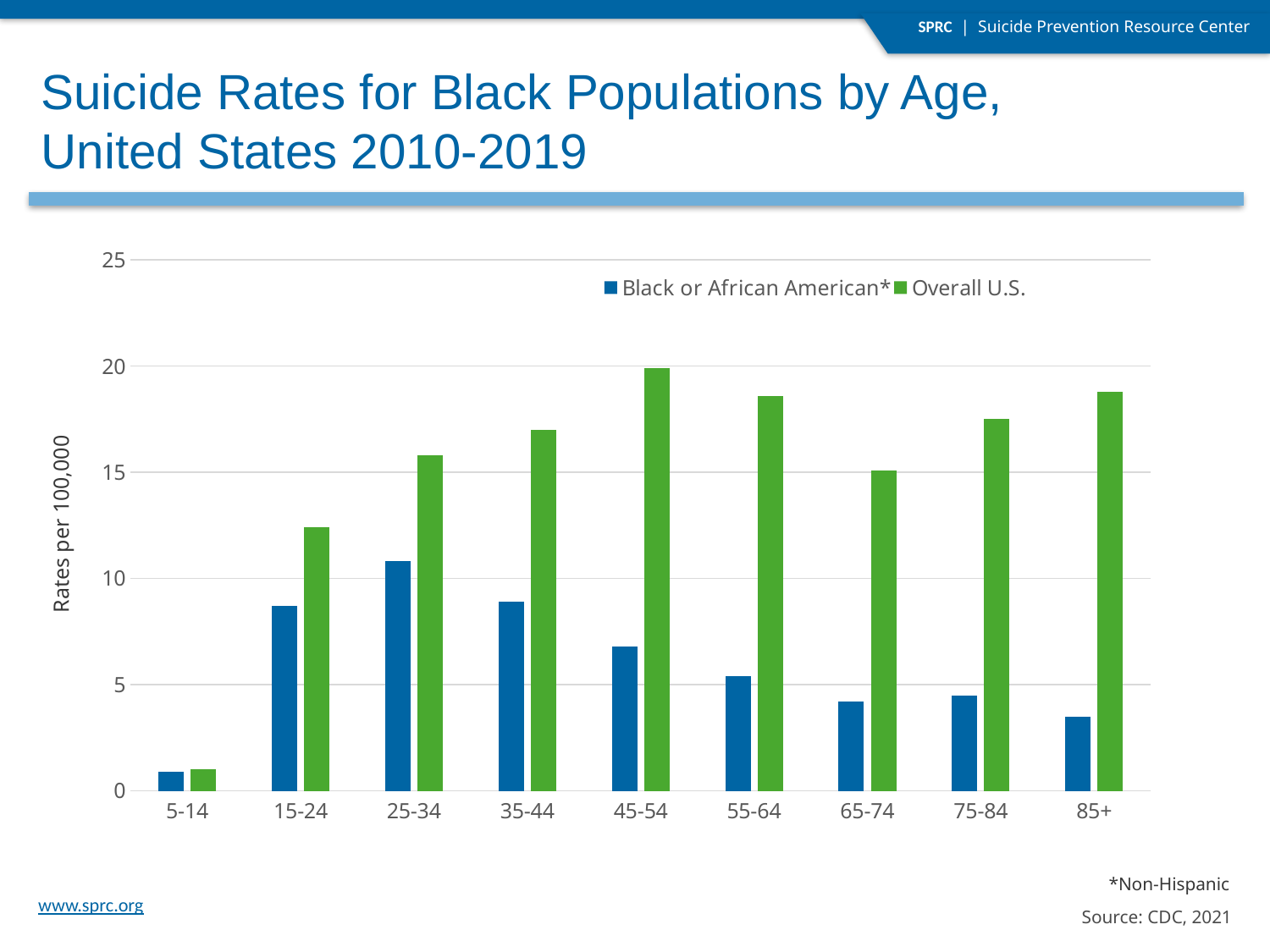
Is the Black or African American* rate for 65-74 greater or less than 5? less What is the label on the y axis? Rates per 100,000 Which age group has the highest rate for Overall U.S.? 45-54 For the 45-54 age group, which series has the larger value, Black or African American* or Overall U.S.? Overall U.S. Which age group has the highest rate for Black or African American*? 25-34 Which age group has the lowest rate for Overall U.S.? 5-14 Is the Black or African American* rate for 25-34 greater or less than 10? greater Does the Overall U.S. rate rise or fall from 5-14 to 45-54? Rise How many series does the legend list? 2 How many age groups are shown on the x axis? 9 What kind of chart is shown on the slide? Bar chart